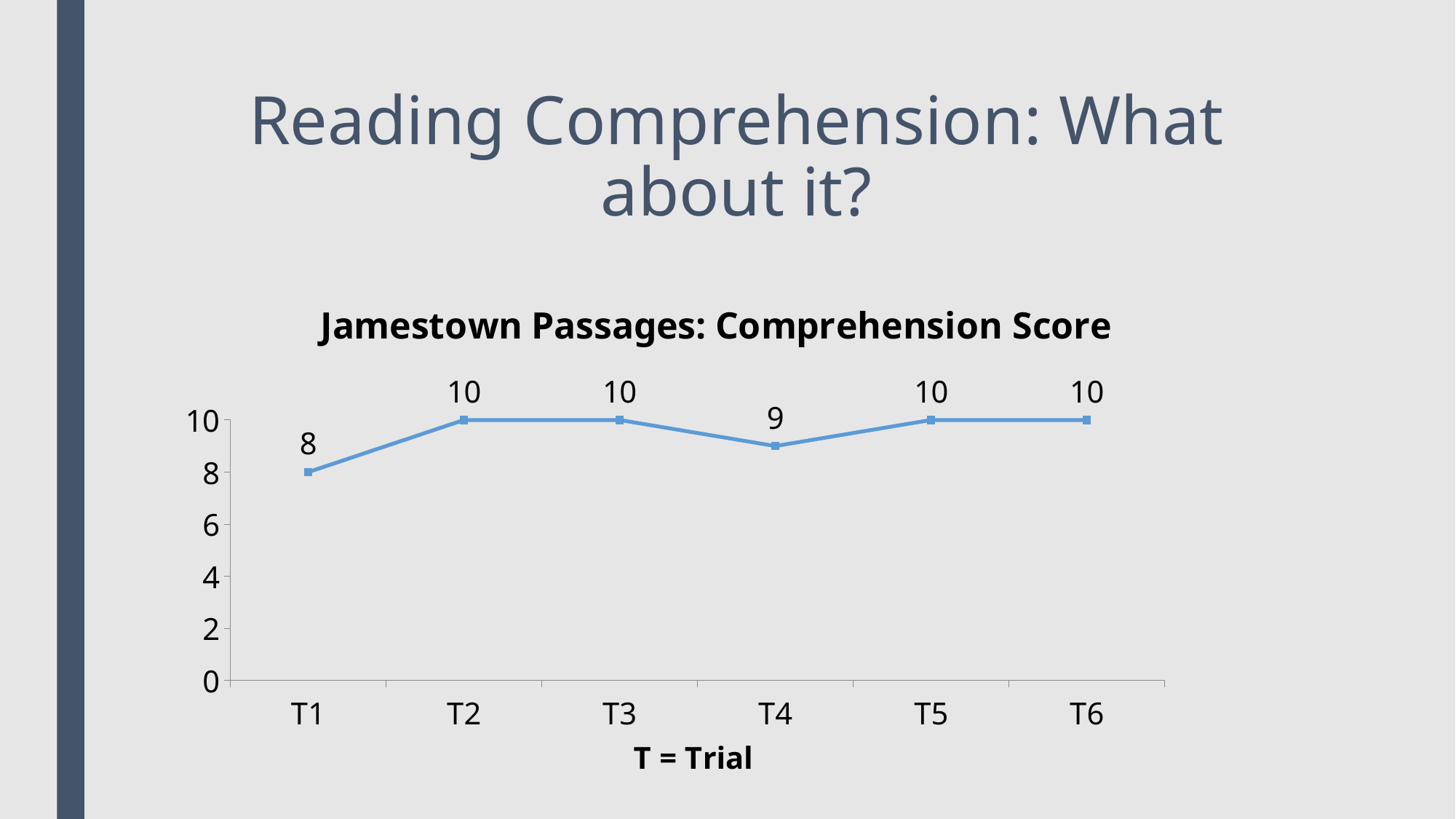
What is the difference between the scores at T3 and T4? 1 What is the comprehension score at T1? 8 How many trials are plotted on the chart? 6 What is the comprehension score at T6? 10 What kind of chart is shown on the slide? line chart What is the difference between the scores at T2 and T1? 2 What is the comprehension score at T4? 9 Is the score at T1 greater or less than 6? greater Which is larger, the score at T4 or the score at T5? T5 Which trial has the lowest comprehension score? T1 What is the title of the chart? Jamestown Passages: Comprehension Score Does the comprehension score rise or fall from T1 to T2? rise